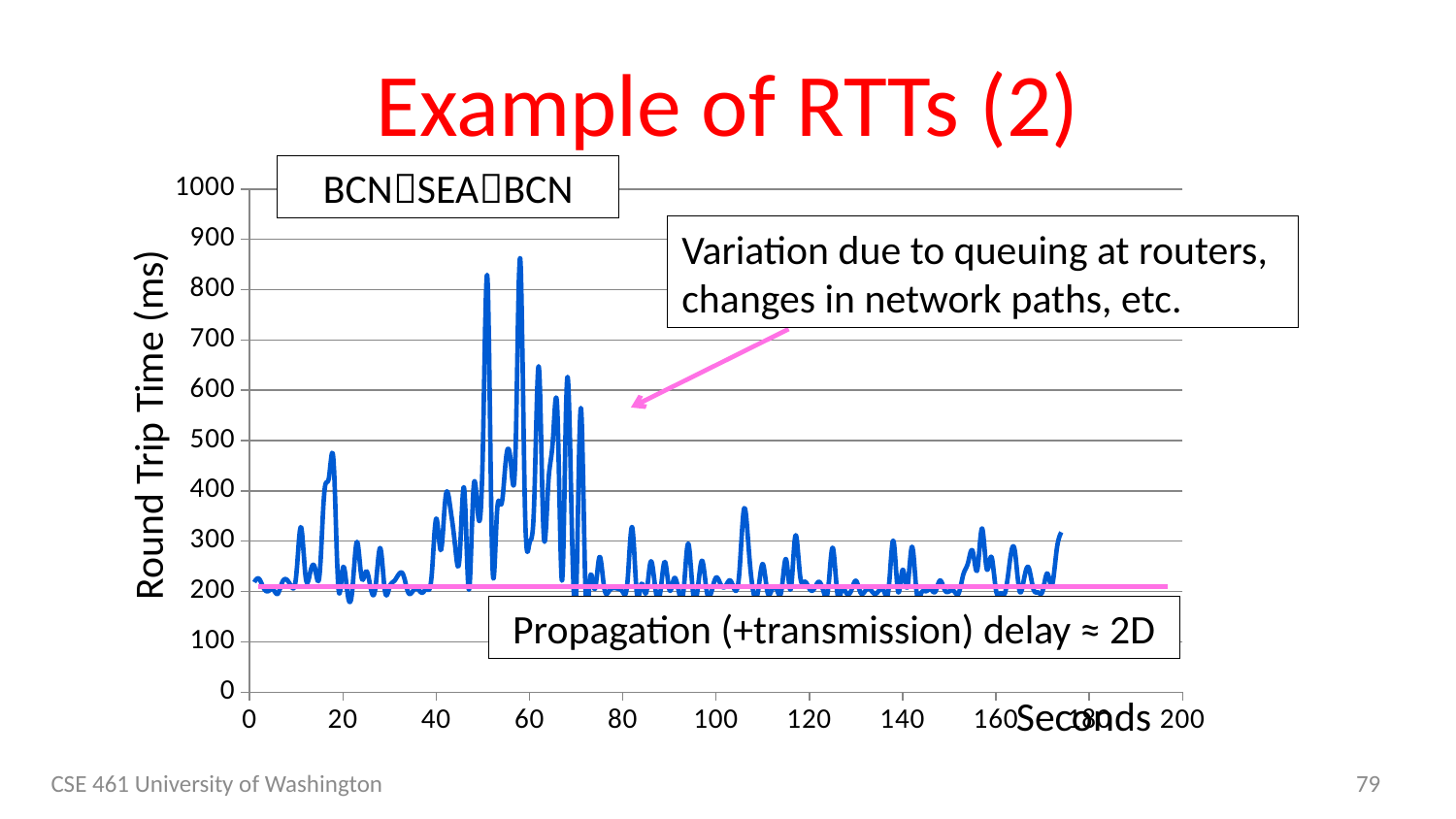
Is the round trip time at 140 seconds greater or less than 400? less What kind of chart is shown on the slide? line chart Is the peak round trip time near 50 seconds greater or less than 700? greater Is the round trip time at 100 seconds greater or less than 500? less What is the label on the vertical axis of the chart? Round Trip Time (ms) What is the label on the horizontal axis of the chart? Seconds Does the round trip time generally rise or fall between 60 and 80 seconds? fall